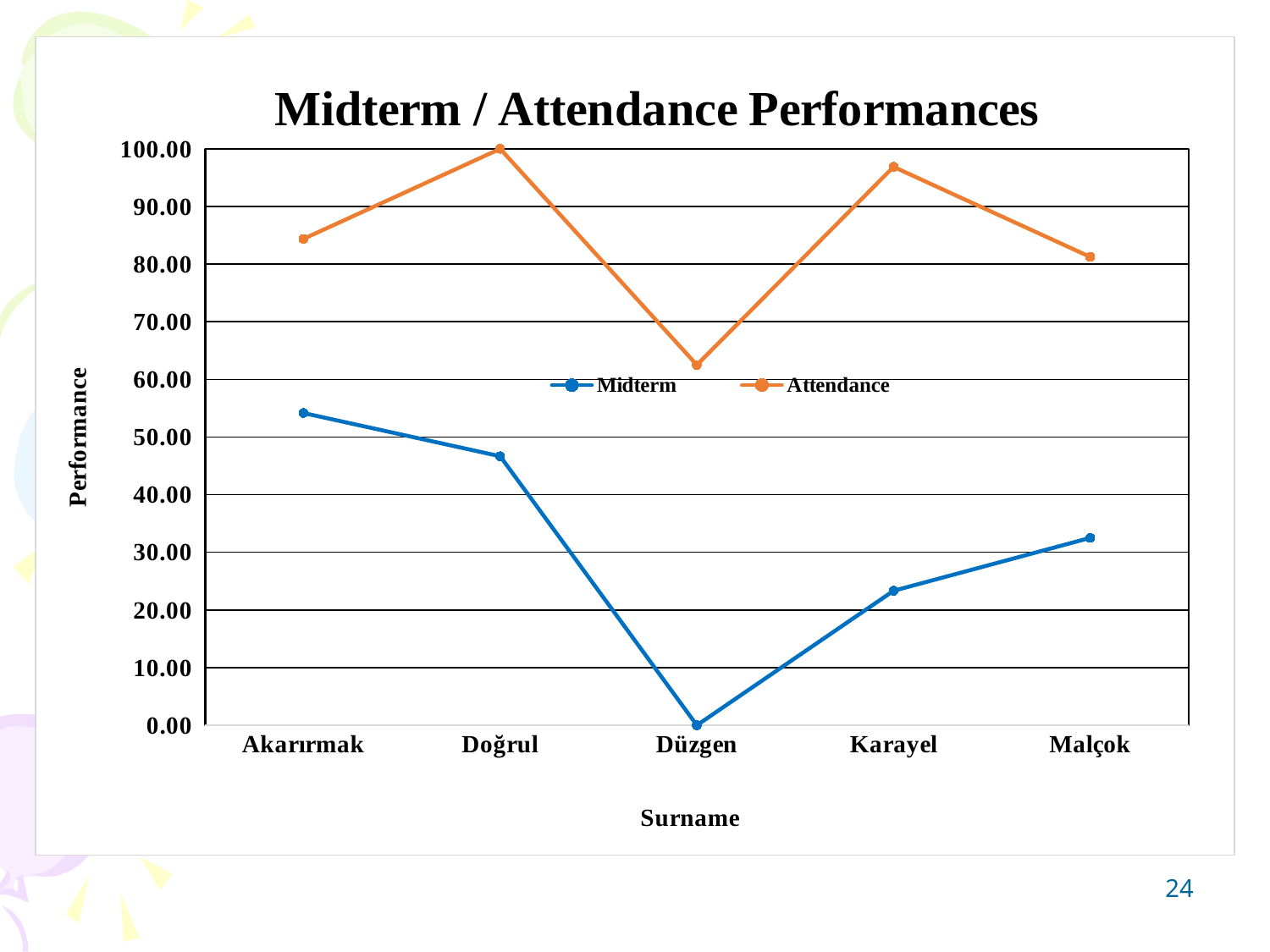
Is the Midterm value for Akarırmak greater or less than 50.00? greater Which surname has the highest Midterm value? Akarırmak What is the Attendance value for Doğrul? 100.00 Is the Attendance value for Karayel greater or less than 90.00? greater How many series does the legend list? 2 What type of chart is shown on the slide? line chart Is the Midterm value for Karayel greater or less than 30.00? less How many surnames are shown on the x axis? 5 For Malçok, which is larger, the Midterm value or the Attendance value? Attendance Which surname has the lowest Attendance value? Düzgen What is the title of the chart? Midterm / Attendance Performances What is the Midterm value for Düzgen? 0.00